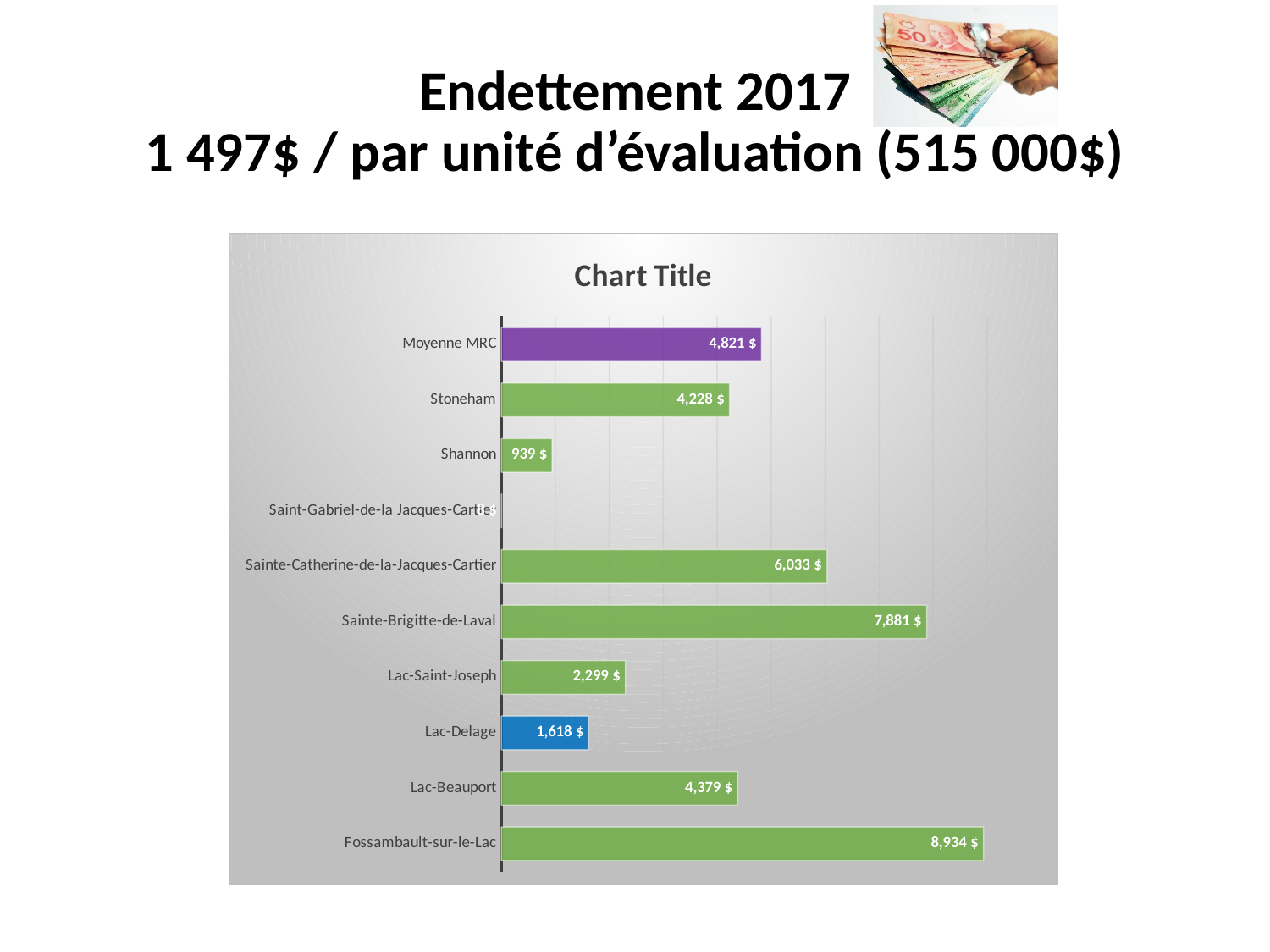
Which is larger, the value for Lac-Saint-Joseph or the value for Lac-Delage? Lac-Saint-Joseph What is the difference between the values for Moyenne MRC and Lac-Delage? 3,203 $ What is the value for Lac-Delage? 1,618 $ What is the difference between the values for Fossambault-sur-le-Lac and Sainte-Brigitte-de-Laval? 1,053 $ What colour is the bar for Moyenne MRC? Purple What is the value for Moyenne MRC? 4,821 $ What is the value for Fossambault-sur-le-Lac? 8,934 $ Which is larger, the value for Lac-Beauport or the value for Stoneham? Lac-Beauport Which category has the highest value? Fossambault-sur-le-Lac What is the value for Sainte-Catherine-de-la-Jacques-Cartier? 6,033 $ What is the value for Shannon? 939 $ What kind of chart is shown on the slide? Bar chart